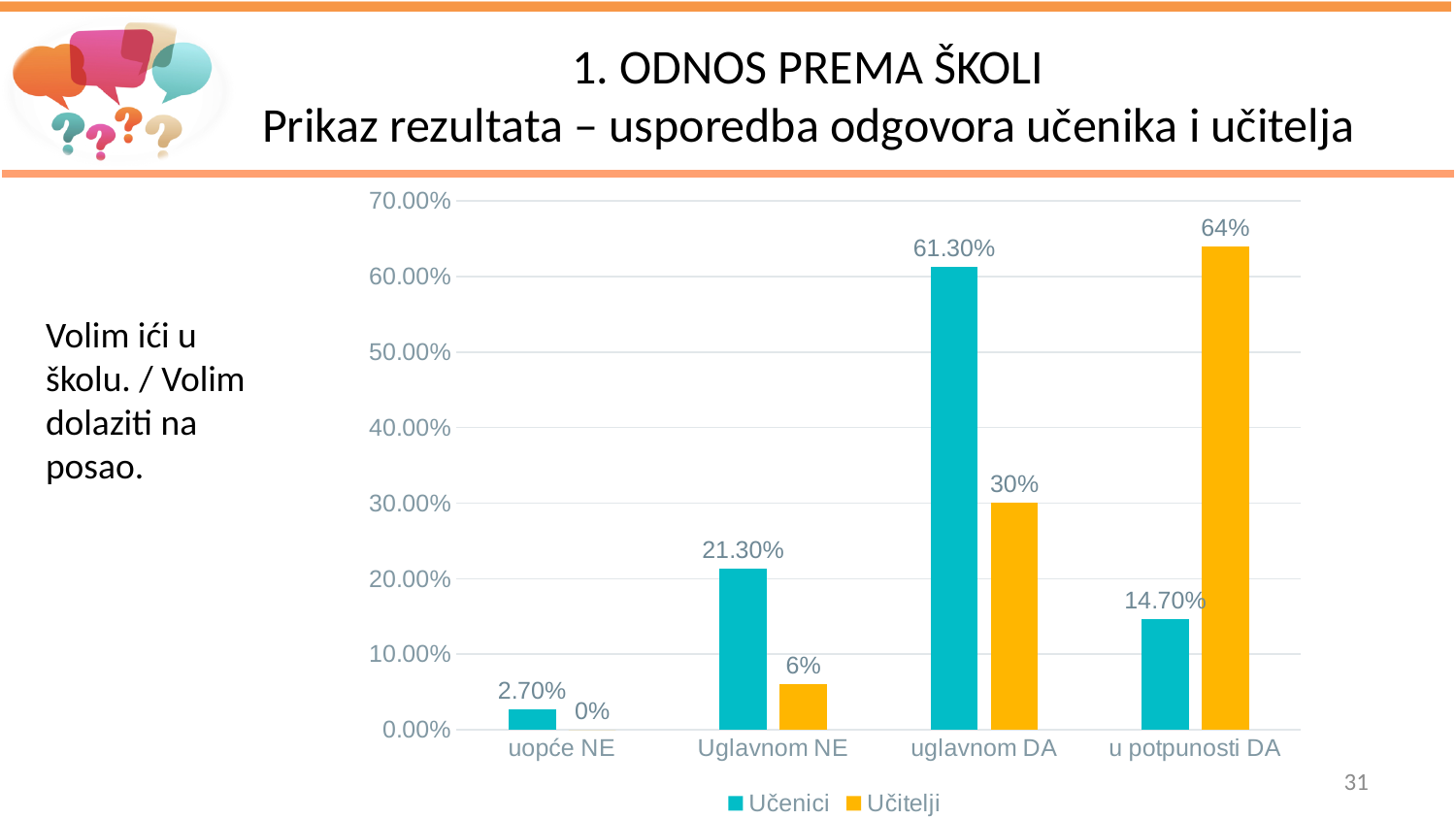
What is the value for Učenici in the 'uglavnom DA' category? 61.30% What is the difference between the Učenici and Učitelji values in the 'uglavnom DA' category? 31.30% How many categories are shown on the x axis? 4 How many series does the legend list? 2 In the 'u potpunosti DA' category, which series has the larger value, Učenici or Učitelji? Učitelji What is the value for Učitelji in the 'uopće NE' category? 0% Is the value for Učitelji in 'uglavnom DA' greater or less than 40.00%? less What kind of chart is shown on the slide? bar chart Which category has the lowest value for Učitelji? uopće NE What is the value for Učenici in the 'Uglavnom NE' category? 21.30% Which category has the highest value for Učenici? uglavnom DA What is the value for Učitelji in the 'u potpunosti DA' category? 64%